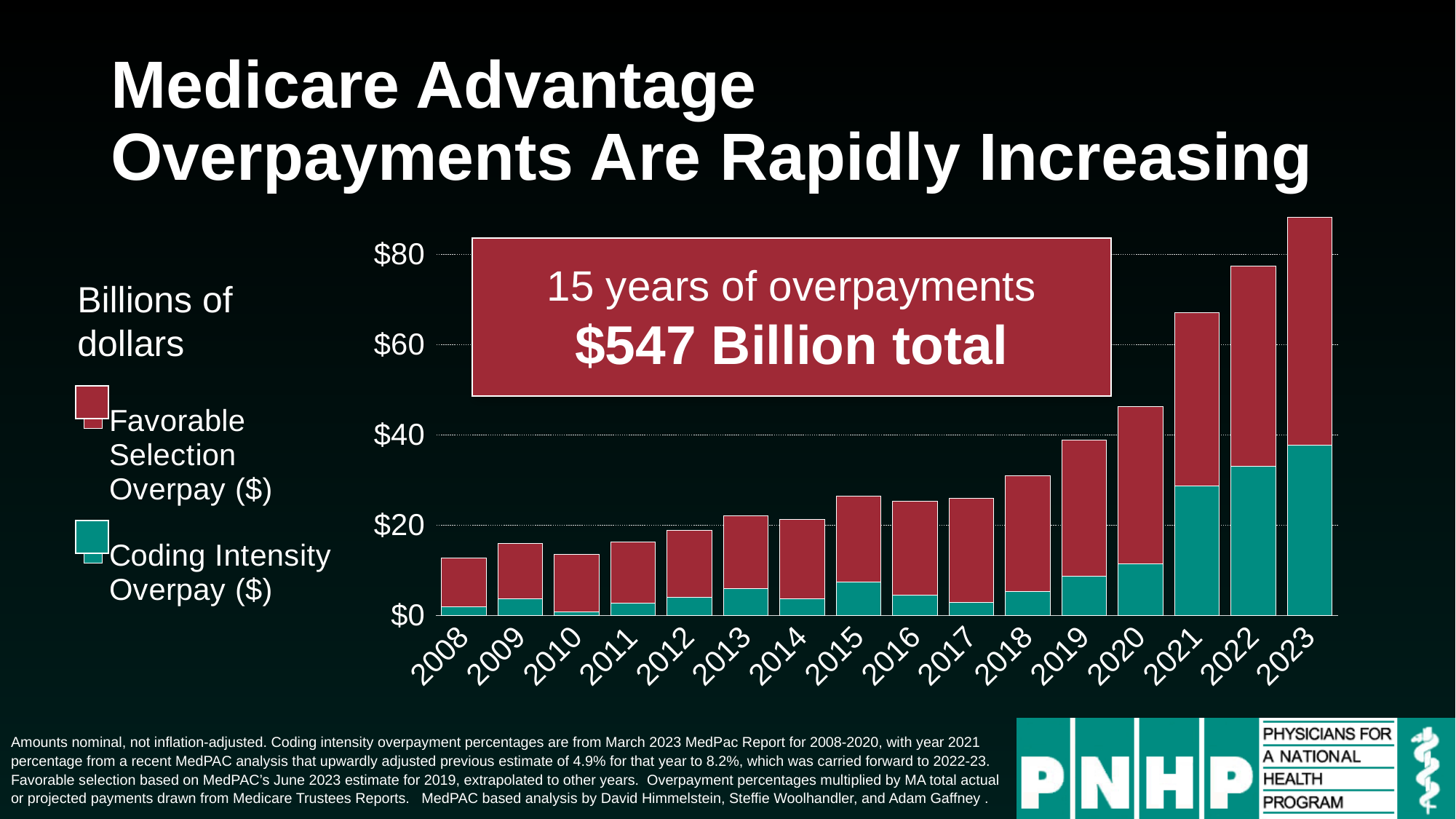
Which year has the tallest stacked bar in the chart? 2023 How many series does the chart's legend list? 2 Is the total overpayment bar for 2008 greater or less than $20? less Is the Coding Intensity Overpay ($) value for 2022 greater or less than $20? greater What kind of chart is shown on the slide? Stacked bar chart Is the total overpayment bar for 2023 greater or less than $80? greater How many years are shown along the x axis of the chart? 16 According to the text box on the chart, what is the 15-year total of overpayments? $547 Billion Which year has the larger total overpayment bar, 2019 or 2022? 2022 Do the total overpayment bars generally rise or fall from 2008 to 2023? rise